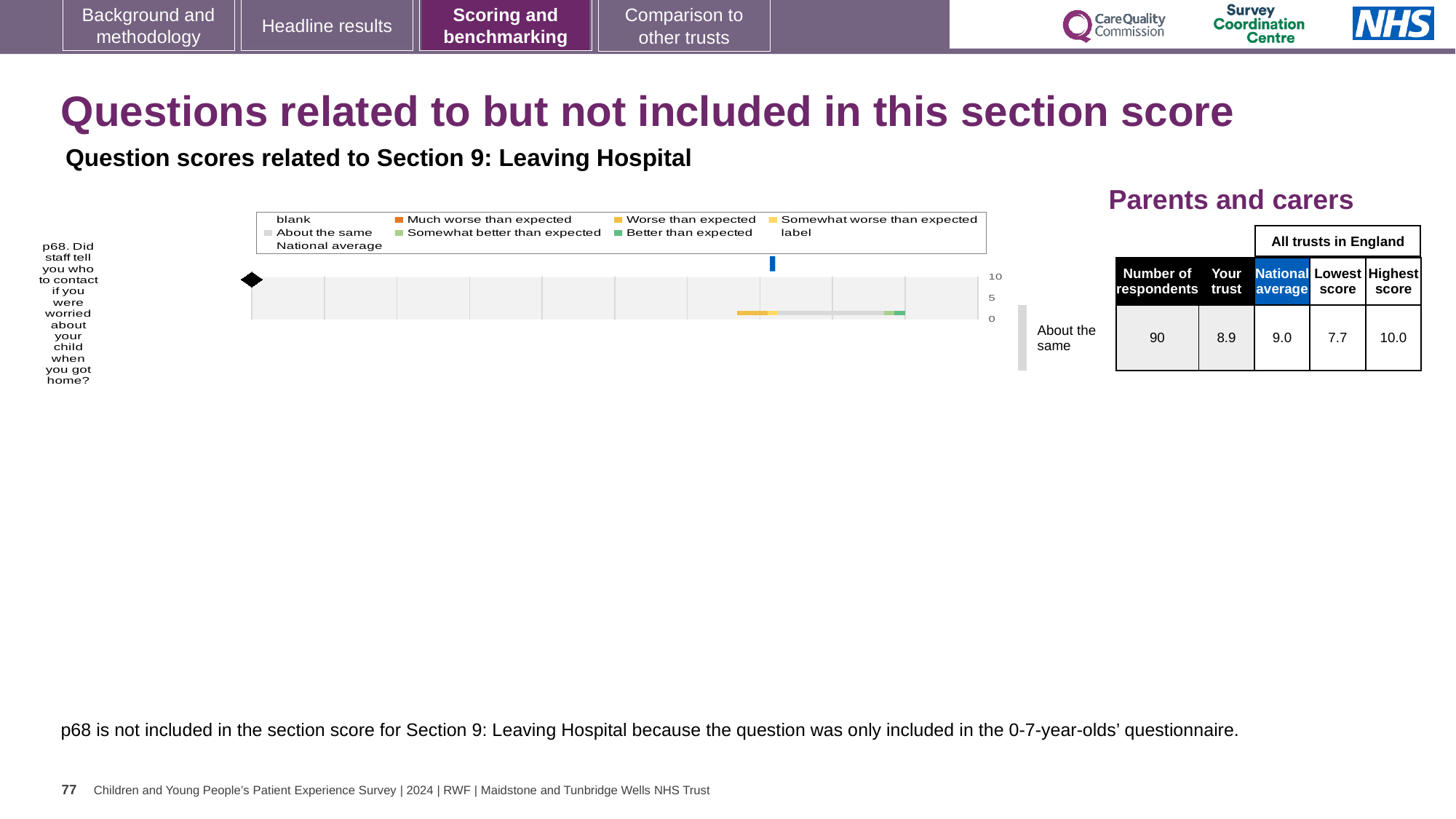
In the table beside the chart, what is the Highest score among all trusts in England for p68? 10.0 In the table beside the chart, what is the Lowest score among all trusts in England for p68? 7.7 Which is larger for p68, the 'Your trust' score or the National average? National average In the table beside the chart, what is the 'Your trust' score for p68? 8.9 What is the difference between the Highest score and the Lowest score for p68? 2.3 What rating label is shown next to the chart for p68? About the same What kind of chart is shown on the slide? bar chart Which group does the chart and table refer to, as stated in the heading above the table? Parents and carers In the table beside the chart, what is the National average for p68? 9.0 How many questions (categories) are plotted in the chart? 1 How many respondents answered p68 according to the table beside the chart? 90 Which question is plotted in the chart? p68. Did staff tell you who to contact if you were worried about your child when you got home?